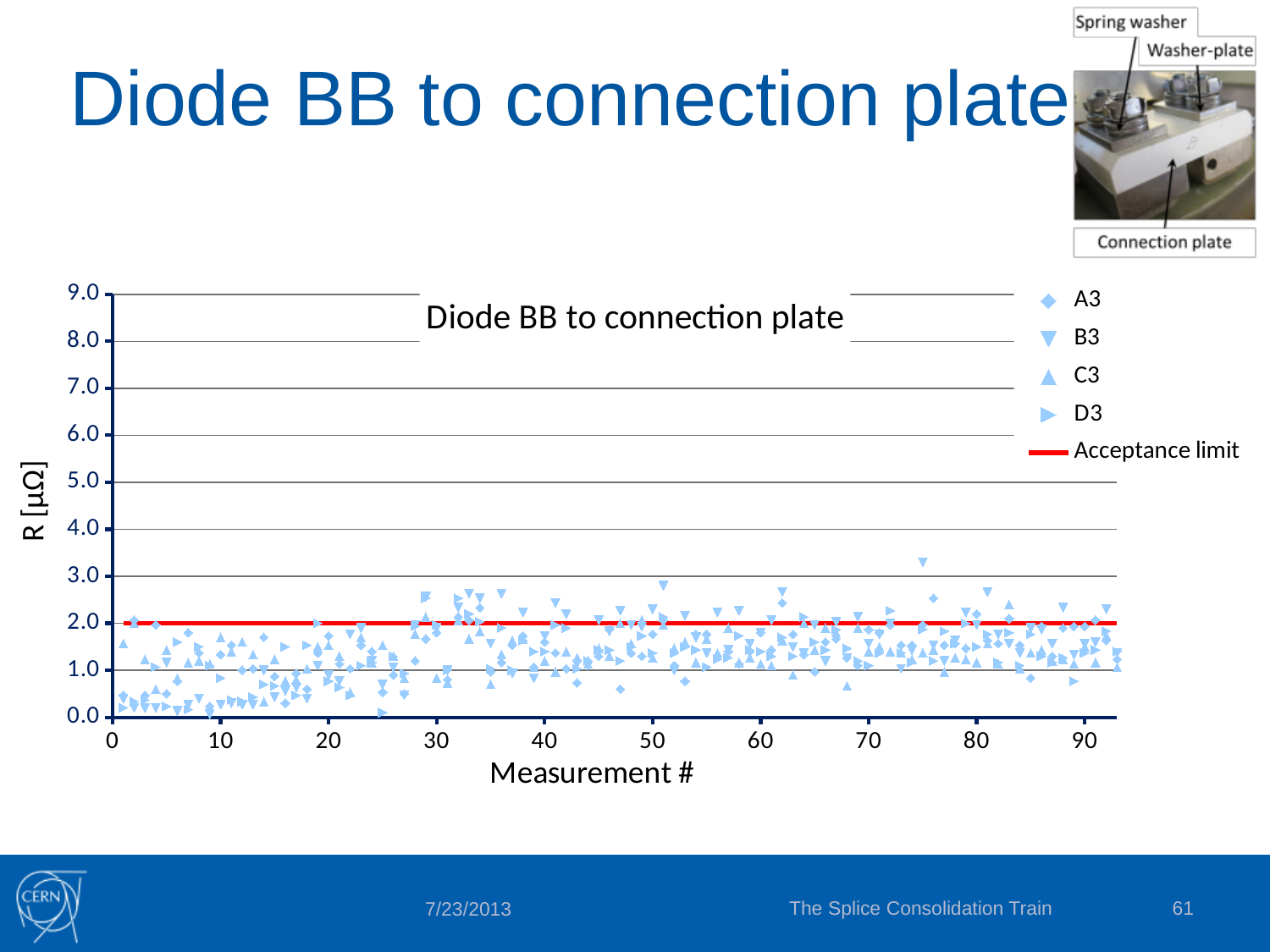
Is the highest plotted data point greater or less than 4.0? less Is the highest plotted data point greater or less than 3.0? greater What is the maximum value shown on the y axis? 9.0 What is the title of the chart? Diode BB to connection plate What is the label of the x axis? Measurement # What kind of chart is shown on the slide? scatter chart Do the measured values generally rise or fall as the measurement number increases from 0 to 90? rise At what value on the y axis is the Acceptance limit line drawn? 2.0 How many entries does the chart legend list? 5